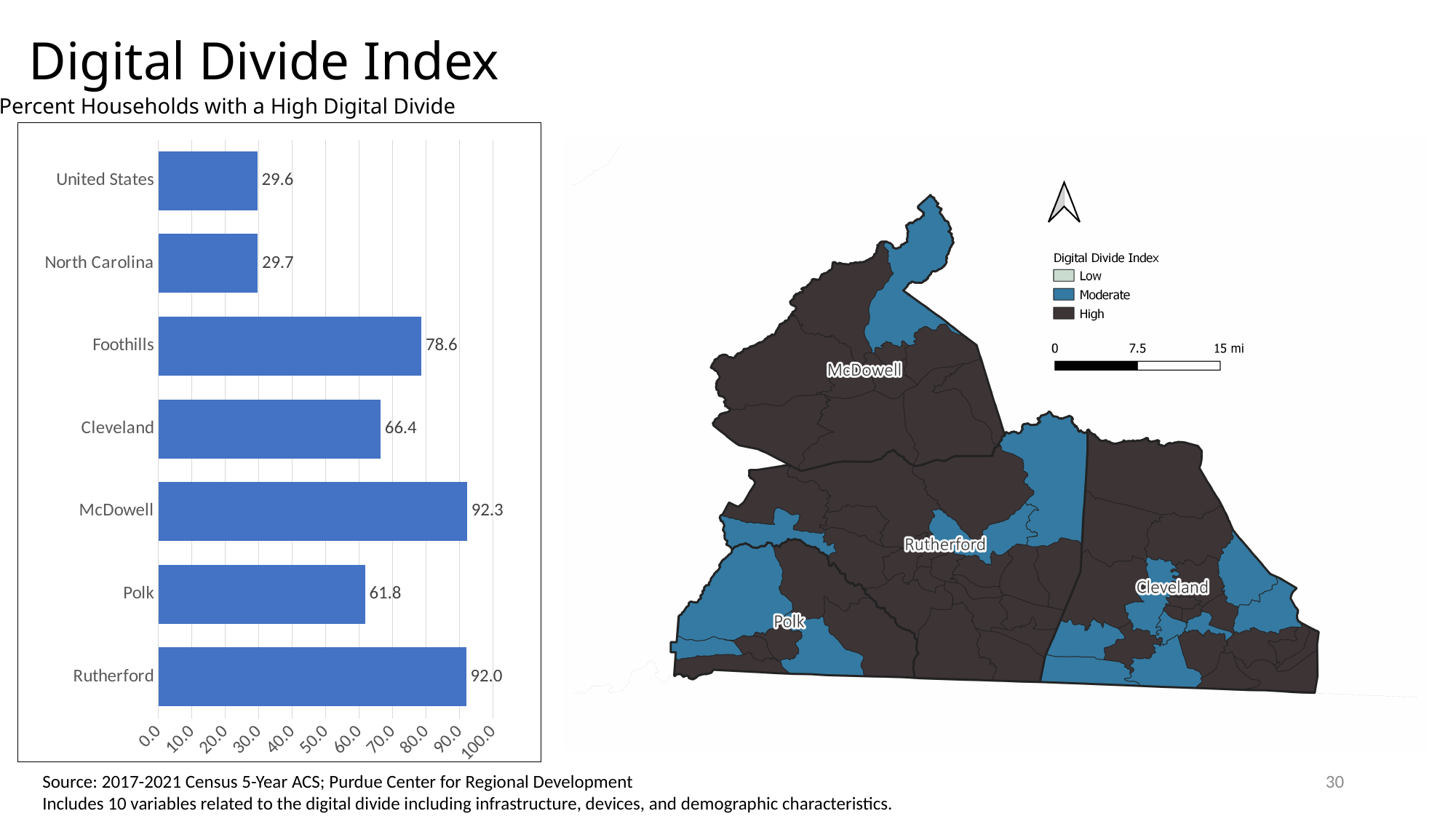
What is the difference between the values for North Carolina and the United States? 0.1 What type of chart is used to show percent households with a high digital divide? Bar chart What is the difference between the values for Foothills and Cleveland? 12.2 Which category has the highest value in the bar chart? McDowell Which has a larger value, Cleveland or Polk? Cleveland What value is shown for McDowell in the bar chart? 92.3 Is the value for Cleveland greater or less than 60.0? greater Which has a larger value, Rutherford or Foothills? Rutherford What is the value for Polk in the bar chart? 61.8 How many categories are shown in the bar chart? 7 What is the percent of households with a high digital divide for Foothills? 78.6 What value does the bar chart show for the United States? 29.6